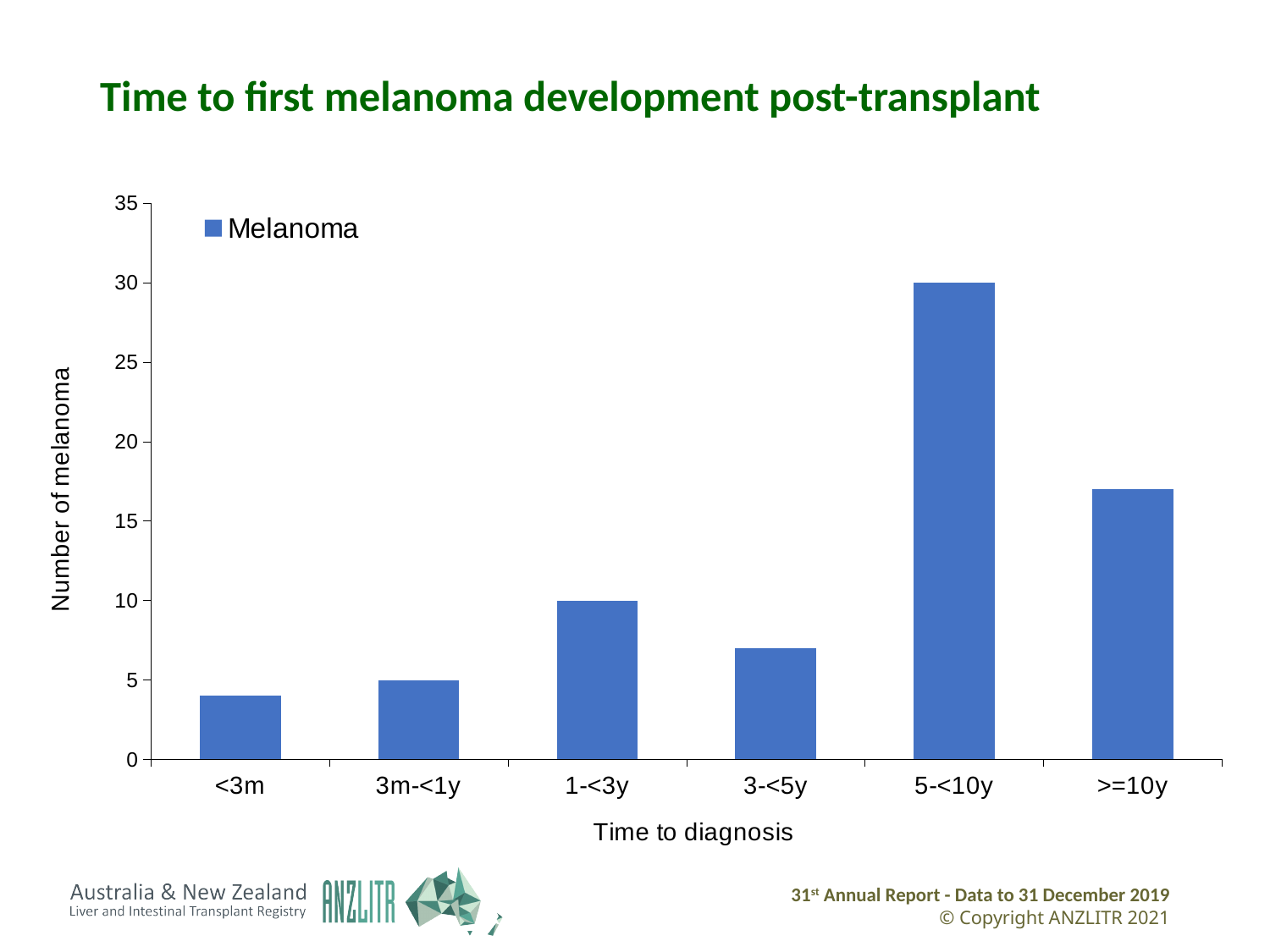
What is the number of melanoma for the 3m-<1y category? 5 Which time-to-diagnosis category has the highest number of melanoma? 5-<10y Which time-to-diagnosis category has the lowest number of melanoma? <3m What type of chart is shown on the slide? bar chart Is the number of melanoma for the >=10y category greater or less than 15? greater How many time-to-diagnosis categories are shown on the x axis? 6 What is the title of the chart? Time to first melanoma development post-transplant Which has more melanoma, the 3-<5y category or the >=10y category? >=10y What is the difference in number of melanoma between the 5-<10y and 1-<3y categories? 20 How many series does the legend list? 1 What is the number of melanoma for the 5-<10y category? 30 What is the number of melanoma for the 1-<3y category? 10